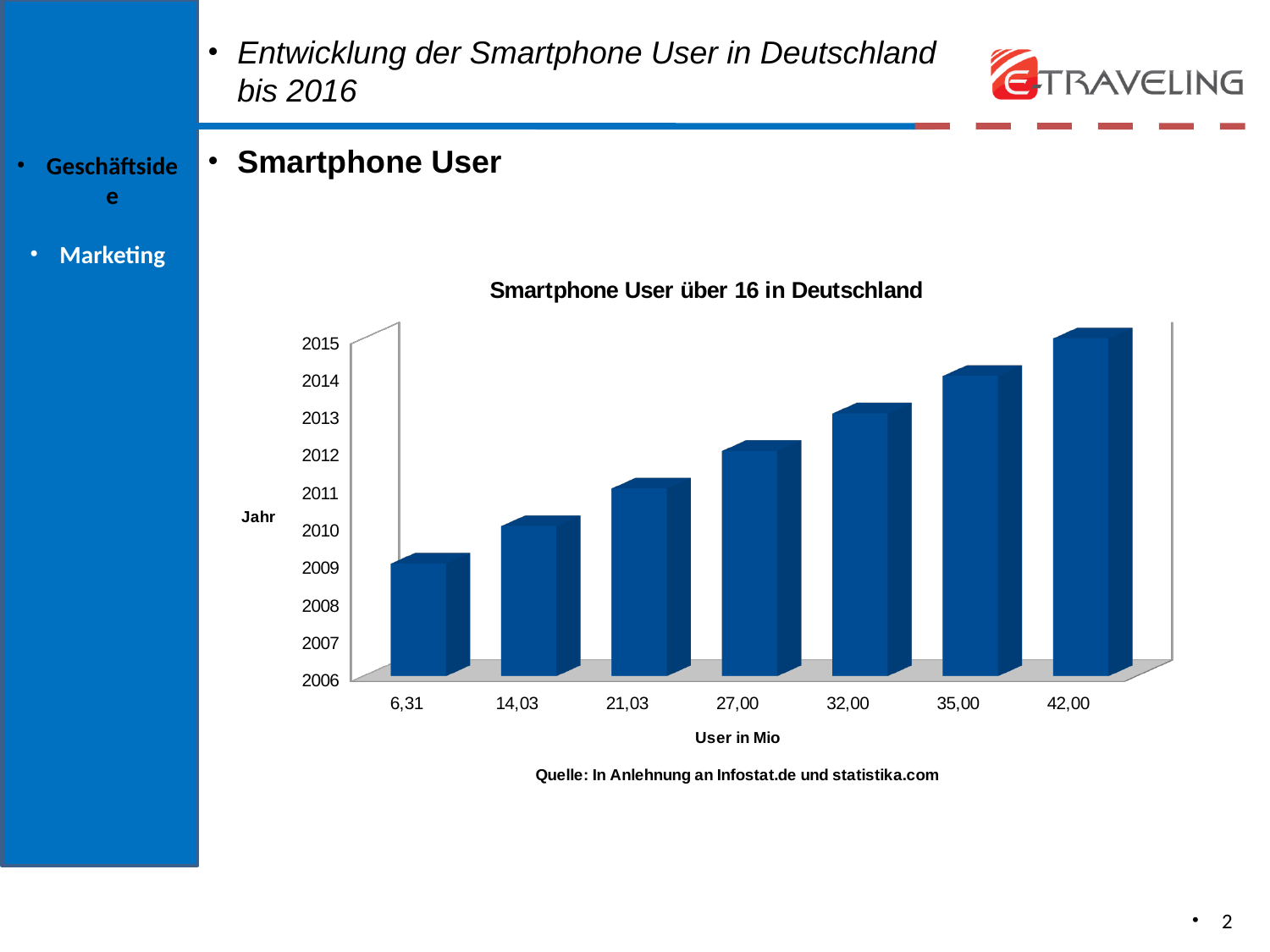
What is the label of the vertical axis of the chart? Jahr Is the bar for 6,31 greater or less than 2012 on the vertical axis? less Do the bars rise or fall from left to right along the x axis? rise How many bars are plotted in the chart? 7 Which x-axis category has the tallest bar? 42,00 Which bar is taller, the one at 27,00 or the one at 6,31? 27,00 Which x-axis category has the shortest bar? 6,31 Is the bar for 42,00 greater or less than 2012 on the vertical axis? greater Which bar is taller, the one at 14,03 or the one at 35,00? 35,00 What is the title of the chart? Smartphone User über 16 in Deutschland What kind of chart is shown on the slide? bar chart Is the bar for 27,00 greater or less than 2010 on the vertical axis? greater